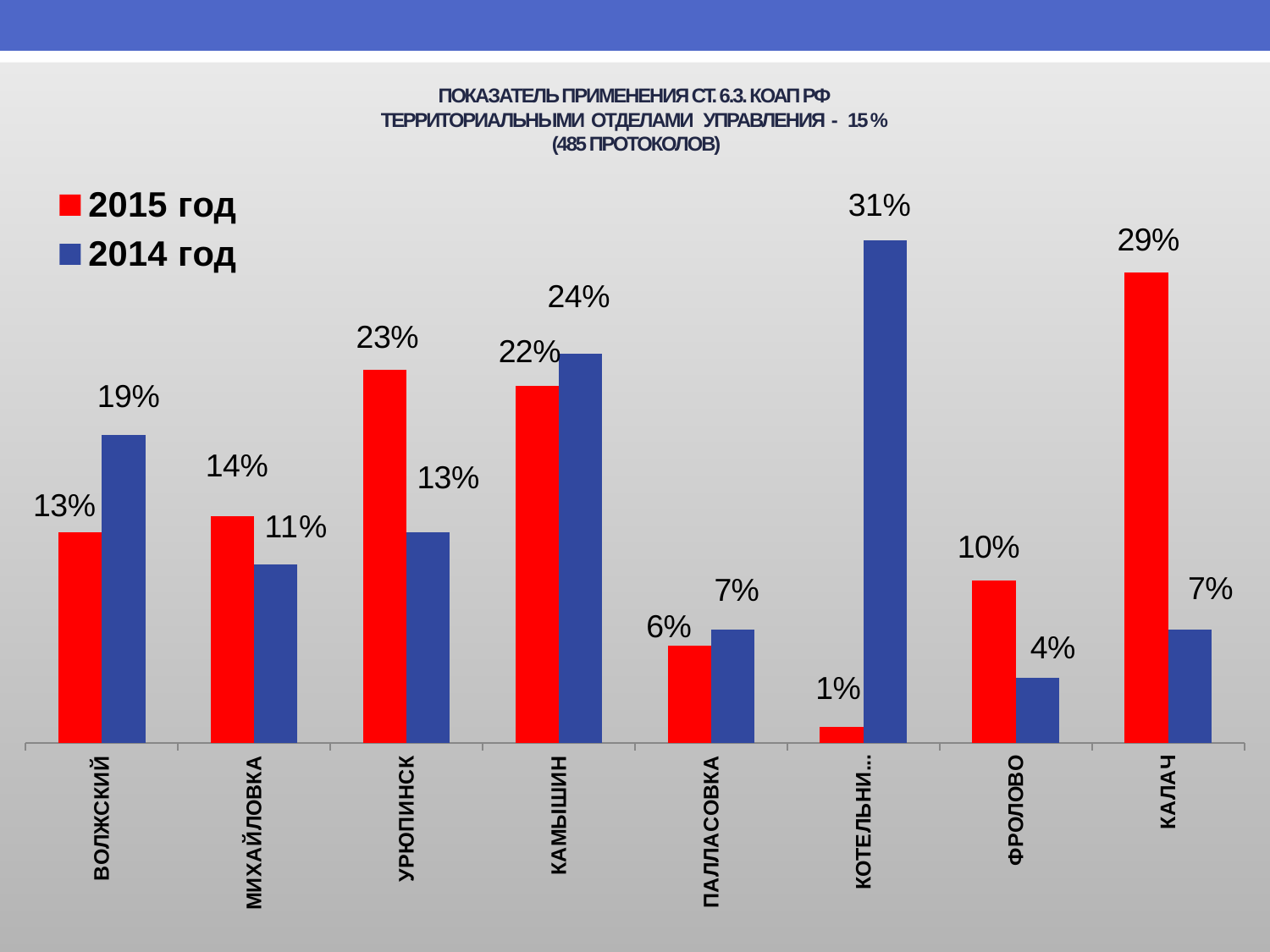
Which is larger for МИХАЙЛОВКА: the 2015 год value or the 2014 год value? 2015 год What is the value for УРЮПИНСК in 2015 год? 23% Which is larger for КАМЫШИН: the 2015 год value or the 2014 год value? 2014 год Which category has the highest value for 2015 год? КАЛАЧ Which colour represents 2015 год in the legend? Red How many categories are shown on the x axis? 8 What is the value for ФРОЛОВО in 2015 год? 10% How many series does the legend list? 2 What is the value for ВОЛЖСКИЙ in 2014 год? 19% What is the difference between the 2015 год and 2014 год values for КАЛАЧ? 22% Which category has the lowest value for 2014 год? ФРОЛОВО What type of chart is shown on the slide? Bar chart